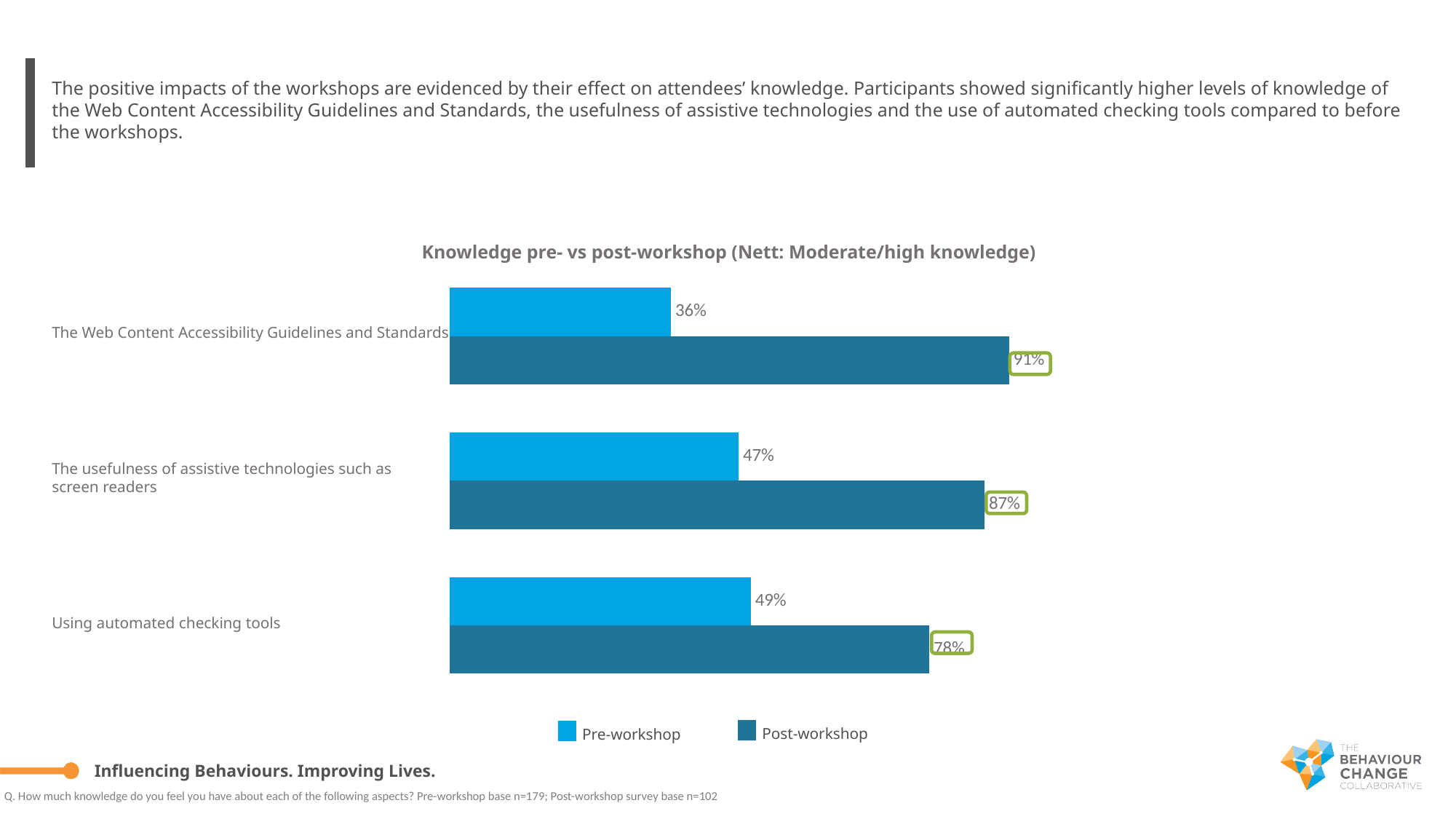
What is the Post-workshop value for The Web Content Accessibility Guidelines and Standards? 91% What kind of chart is shown on the slide? Bar chart Which category has the highest Post-workshop value? The Web Content Accessibility Guidelines and Standards What is the Pre-workshop value for The Web Content Accessibility Guidelines and Standards? 36% What is the Pre-workshop value for The usefulness of assistive technologies such as screen readers? 47% Which category has the lowest Pre-workshop value? The Web Content Accessibility Guidelines and Standards What is the difference between the Post-workshop and Pre-workshop values for The Web Content Accessibility Guidelines and Standards? 55% How many categories are shown in the chart? 3 What is the difference between the Post-workshop and Pre-workshop values for Using automated checking tools? 29% What is the Post-workshop value for Using automated checking tools? 78% Which is larger: the Post-workshop value for The usefulness of assistive technologies such as screen readers or the Post-workshop value for Using automated checking tools? The usefulness of assistive technologies such as screen readers How many series does the legend list? 2